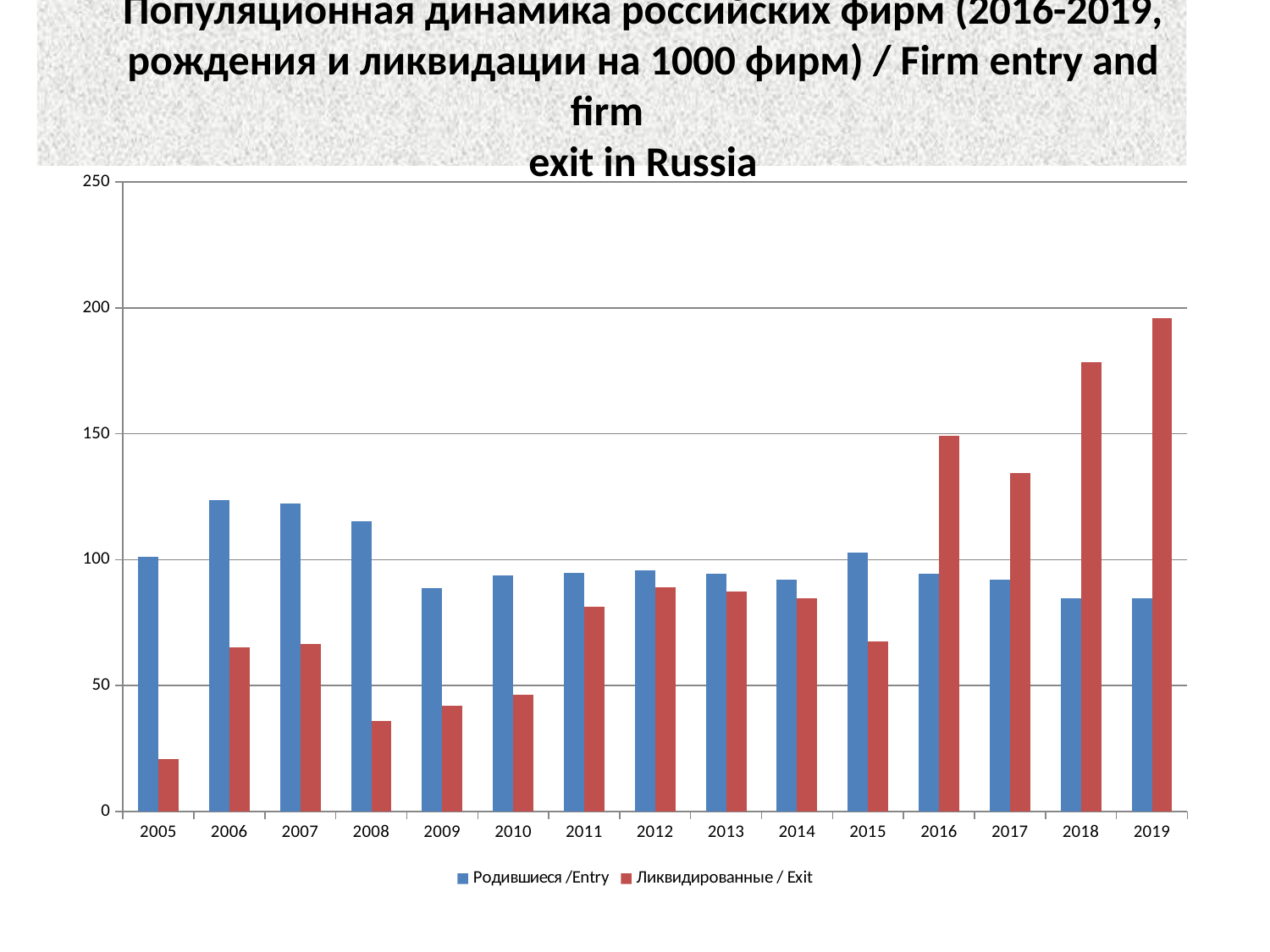
Is the value for Ликвидированные / Exit in 2019 greater or less than 150? greater Is the value for Родившиеся /Entry in 2009 greater or less than 100? less Do the values for Родившиеся /Entry rise or fall from 2006 to 2009? fall How many years are shown on the x axis? 15 Is the value for Родившиеся /Entry in 2008 greater or less than 100? greater In 2019, which is larger: Родившиеся /Entry or Ликвидированные / Exit? Ликвидированные / Exit How many series does the legend list? 2 Which year has the highest value for Ликвидированные / Exit? 2019 Which year has the lowest value for Ликвидированные / Exit? 2005 In 2005, which is larger: Родившиеся /Entry or Ликвидированные / Exit? Родившиеся /Entry What kind of chart is shown on the slide? bar chart